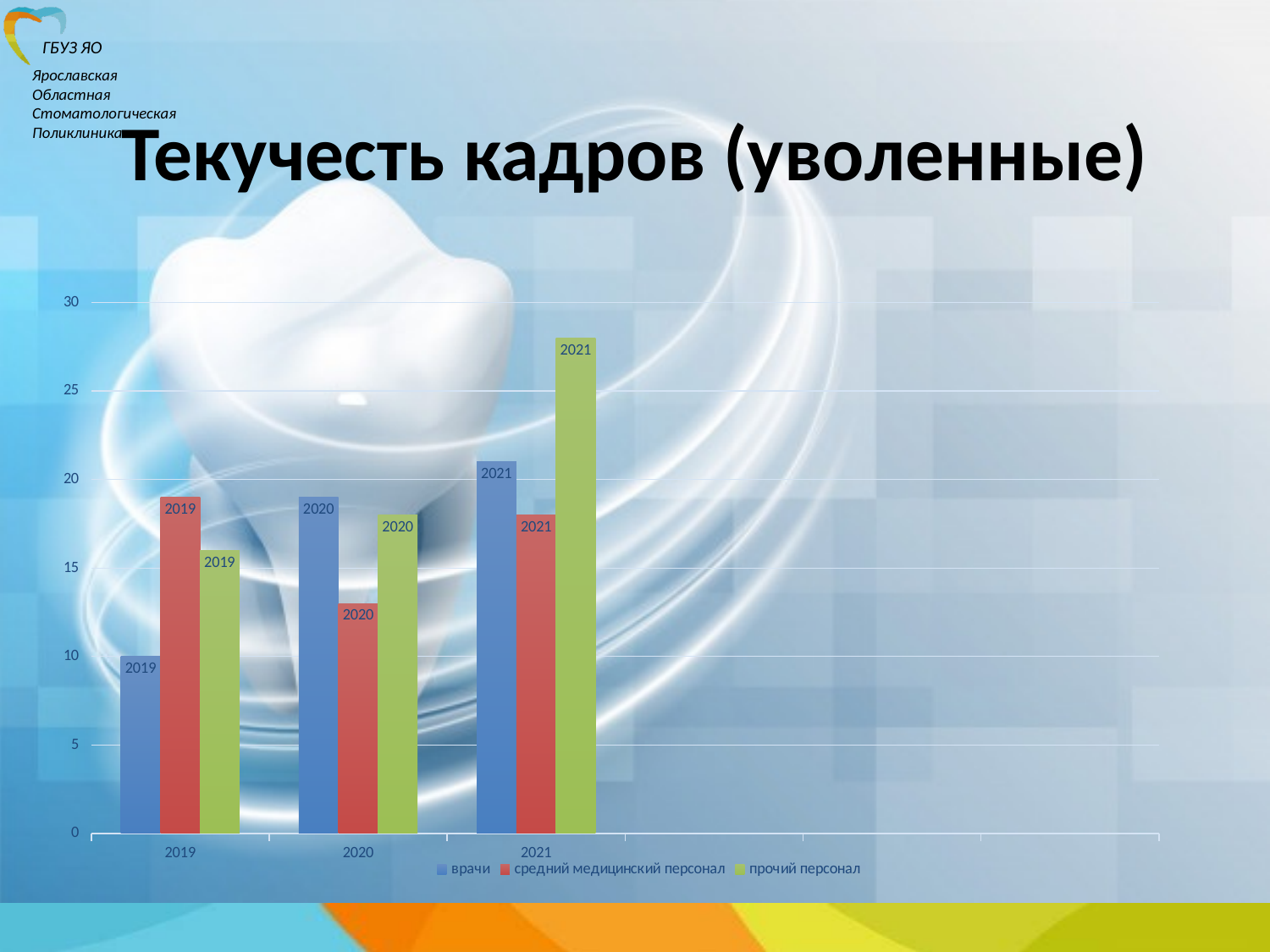
What is the title of the chart? Текучесть кадров (уволенные) In 2019, which is larger: the value for средний медицинский персонал or for прочий персонал? средний медицинский персонал Is the value for врачи in 2019 greater or less than 15? less In which year is the value for врачи the lowest? 2019 How many year categories are shown on the x axis? 3 In 2021, which is larger: the value for врачи or for прочий персонал? прочий персонал What kind of chart is shown on the slide? bar chart In which year is the value for прочий персонал the highest? 2021 How many series does the legend list? 3 Do the values for врачи rise or fall from 2019 to 2021? rise Is the value for средний медицинский персонал in 2020 greater or less than 15? less Is the value for прочий персонал in 2021 greater or less than 25? greater